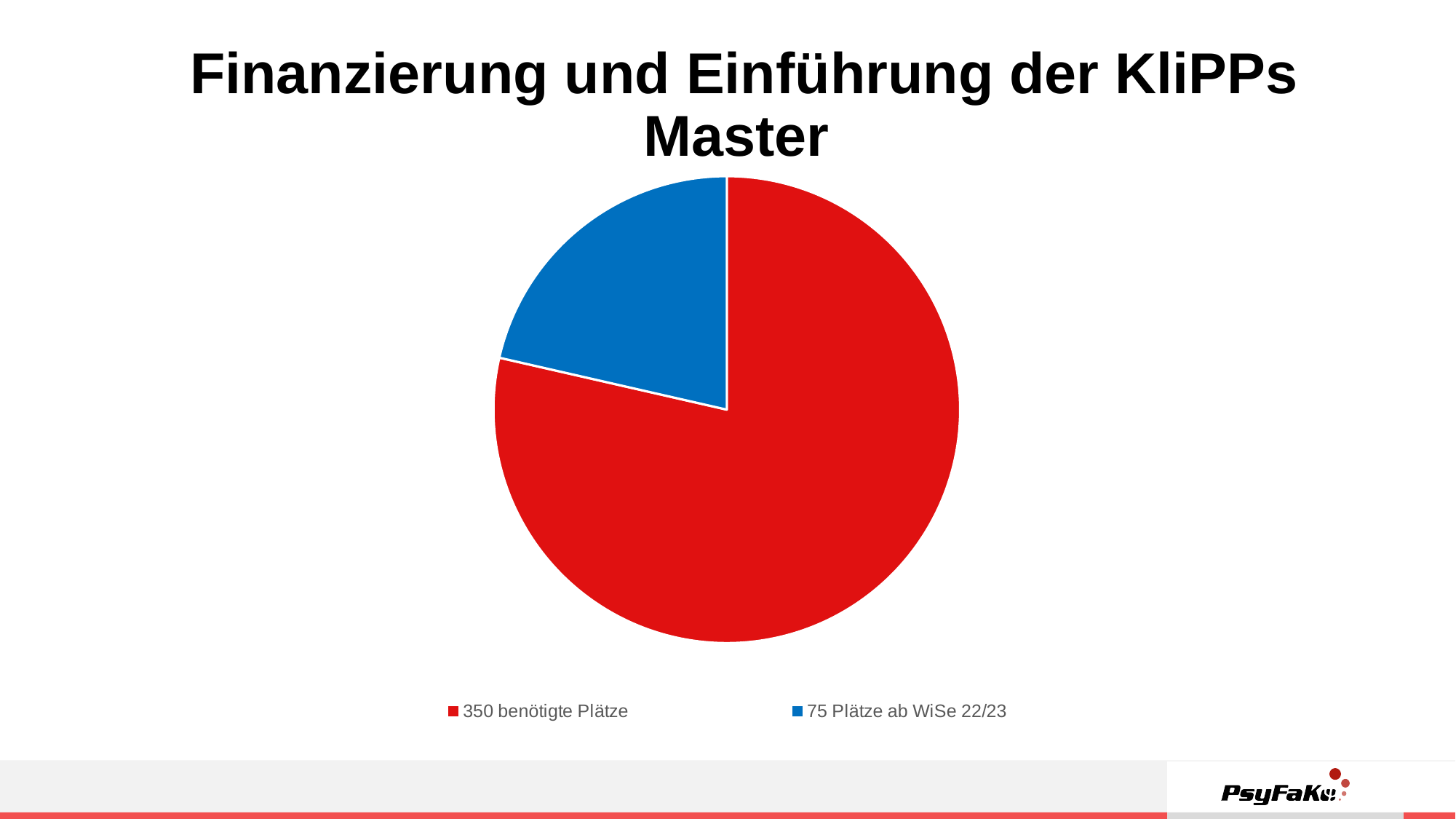
Which slice of the pie chart is the smallest? 75 Plätze ab WiSe 22/23 Which slice of the pie chart is the largest? 350 benötigte Plätze How many slices does the pie chart have? 2 How many entries does the legend of the pie chart list? 2 What is the title of the slide containing the pie chart? Finanzierung und Einführung der KliPPs Master What colour is the slice for "75 Plätze ab WiSe 22/23"? blue What kind of chart is shown on the slide? pie chart Which slice is larger, "350 benötigte Plätze" or "75 Plätze ab WiSe 22/23"? 350 benötigte Plätze